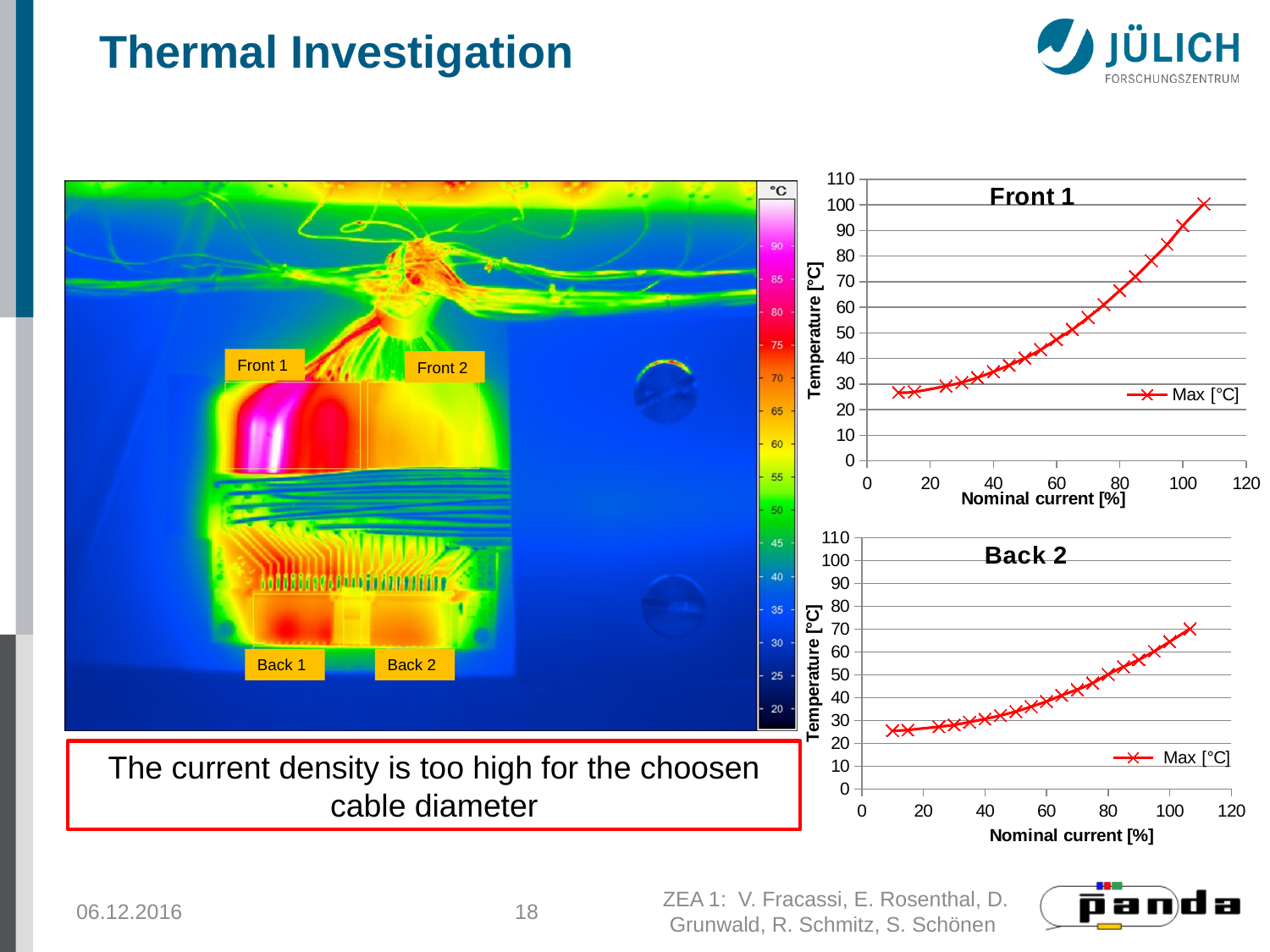
How many series does the legend of the "Front 1" chart list? 1 At the highest nominal current plotted, which chart shows the higher maximum temperature, "Front 1" or "Back 2"? Front 1 What is the x-axis label of the "Front 1" chart? Nominal current [%] What kind of chart is the "Back 2" chart? line chart In the "Back 2" chart, is the temperature at 60% nominal current greater or less than 50? less In the "Back 2" chart, does the temperature rise or fall as nominal current increases? rise In the "Back 2" chart, is the temperature at 80% nominal current greater or less than 60? less What kind of chart is the "Front 1" chart? line chart What is the legend entry in the "Back 2" chart? Max [°C] In the "Front 1" chart, does the temperature rise or fall as nominal current increases? rise In the "Front 1" chart, is the temperature at 100% nominal current greater or less than 80? greater